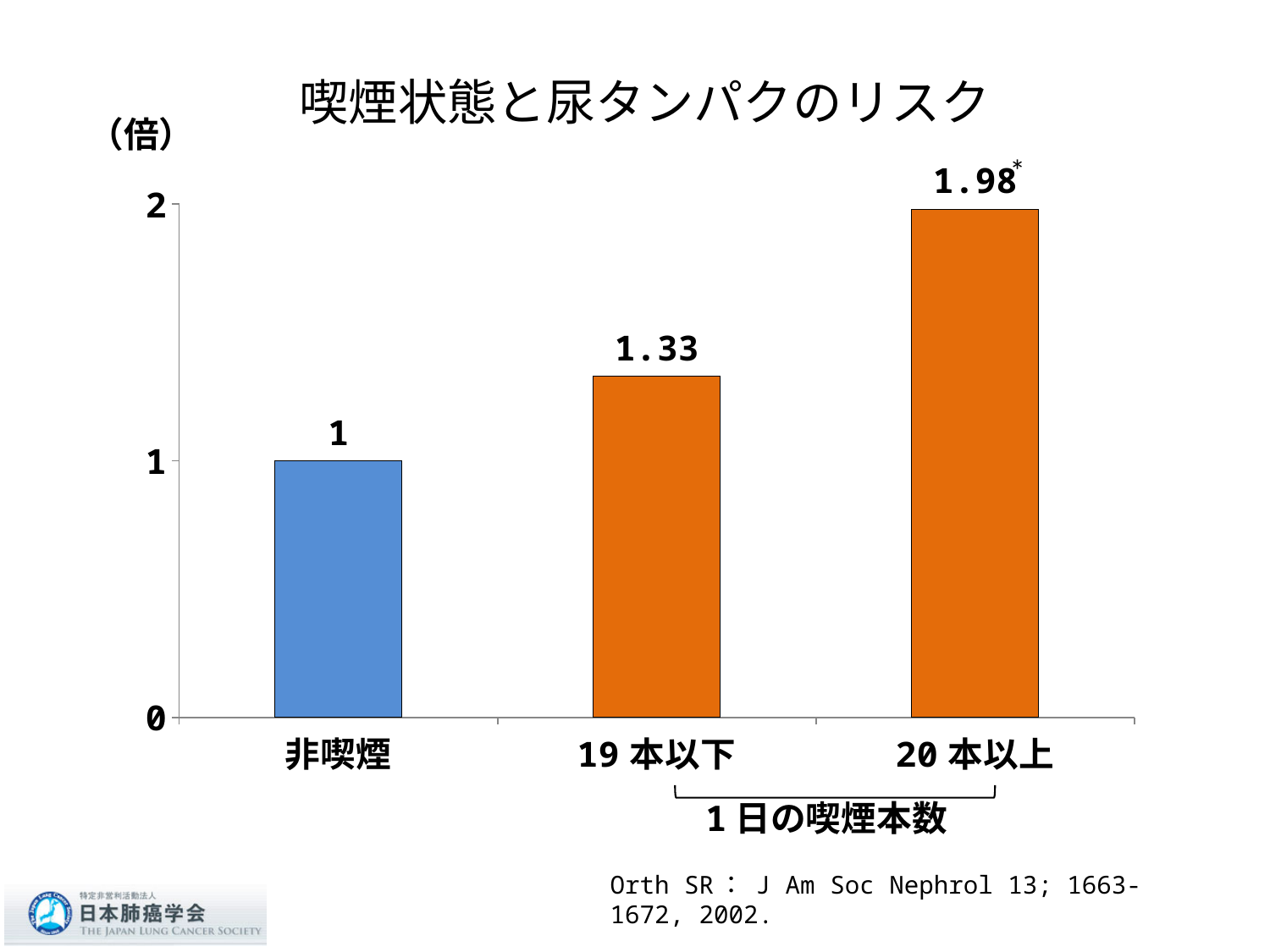
Is the value for 19本以下 greater or less than 1? greater What is the value for 非喫煙? 1 Which is larger, the value for 19本以下 or the value for 20本以上? 20本以上 What is the value for 19本以下? 1.33 What is the difference between the values for 20本以上 and 19本以下? 0.65 Which category has the lowest value? 非喫煙 What is the difference between the values for 20本以上 and 非喫煙? 0.98 What is the value for 20本以上? 1.98 How many categories are shown on the x axis? 3 What kind of chart is shown on the slide? bar chart Which category has the highest value? 20本以上 What is the title of the chart? 喫煙状態と尿タンパクのリスク